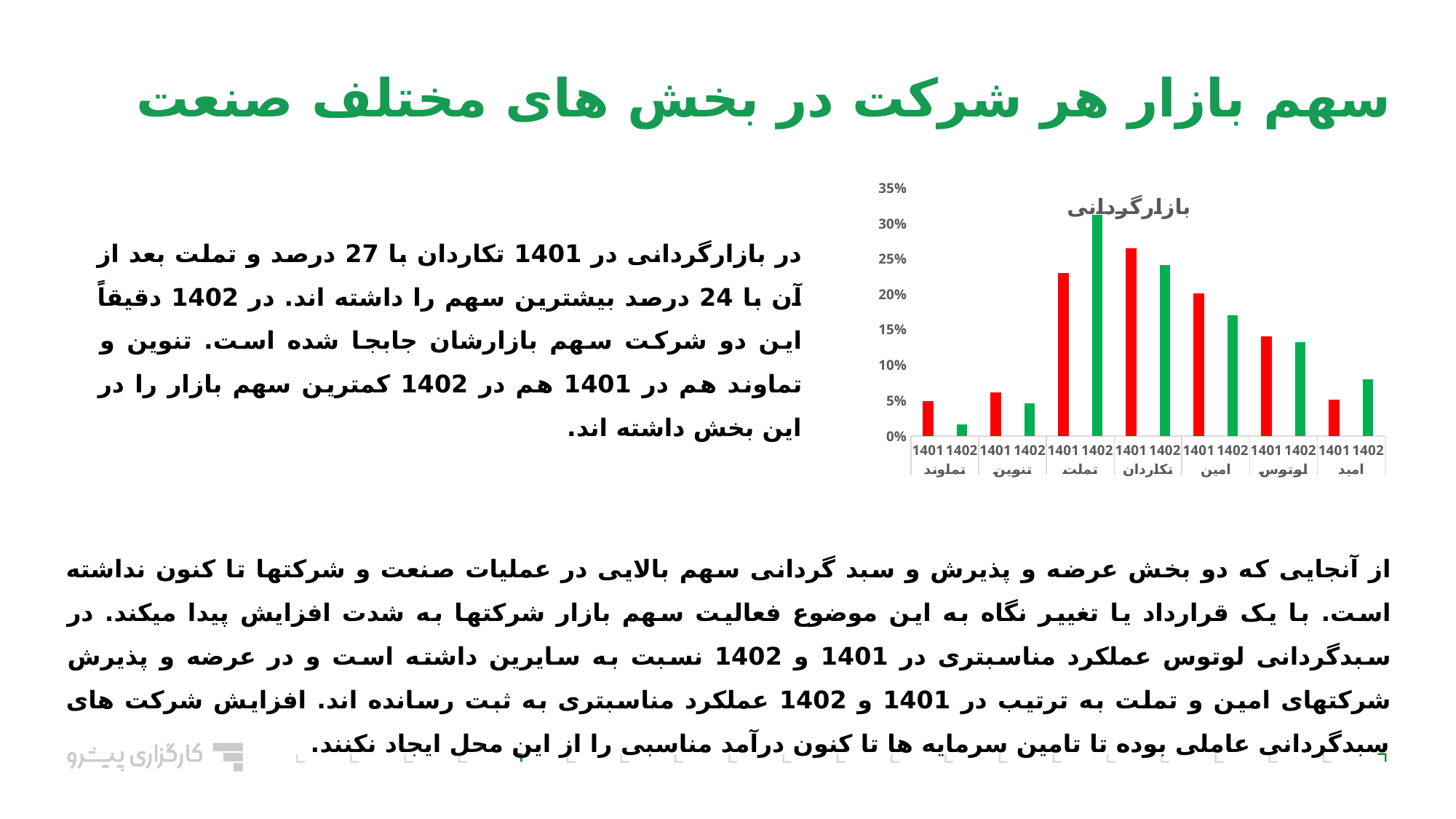
Is the value for تملت in 1402 greater or less than 25%? greater Which bar in the chart is the highest? تملت 1402 For تملت, which year has the larger value, 1401 or 1402? 1402 Among the 1401 bars, which company has the highest value? تکاردان How many companies are shown on the x axis of the chart? 7 Is the value for لوتوس in 1402 greater or less than 15%? less What kind of chart is shown on the slide? bar chart What is the title of the chart? بازارگردانی Which bar in the chart is the lowest? تماوند 1402 For تکاردان, which year has the larger value, 1401 or 1402? 1401 Is the value for تکاردان in 1401 greater or less than 20%? greater For امید, which year has the larger value, 1401 or 1402? 1402